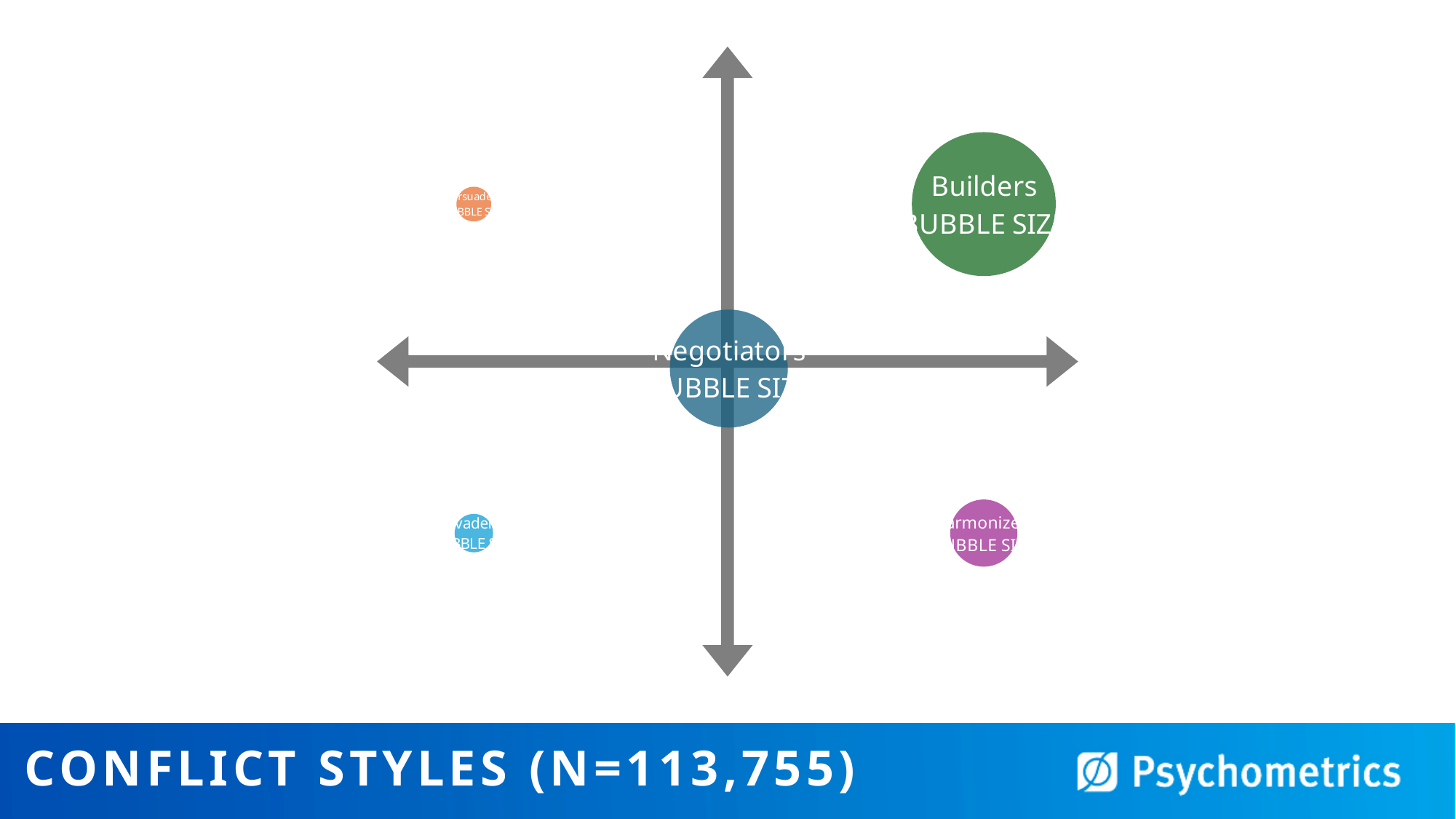
What colour is the Builders bubble? green Which bubble sits at the intersection of the two axes? Negotiators What kind of chart is shown on the slide? bubble chart Which bubble is larger, Builders or Negotiators? Builders In which quadrant of the chart is the Builders bubble located? upper right How many bubbles are plotted on the chart? 5 What sample size (N) is given in the slide title? 113,755 Which bubble is the largest on the chart? Builders In which quadrant of the chart is the Harmonizers bubble located? lower right Which bubble is larger, Negotiators or Harmonizers? Negotiators